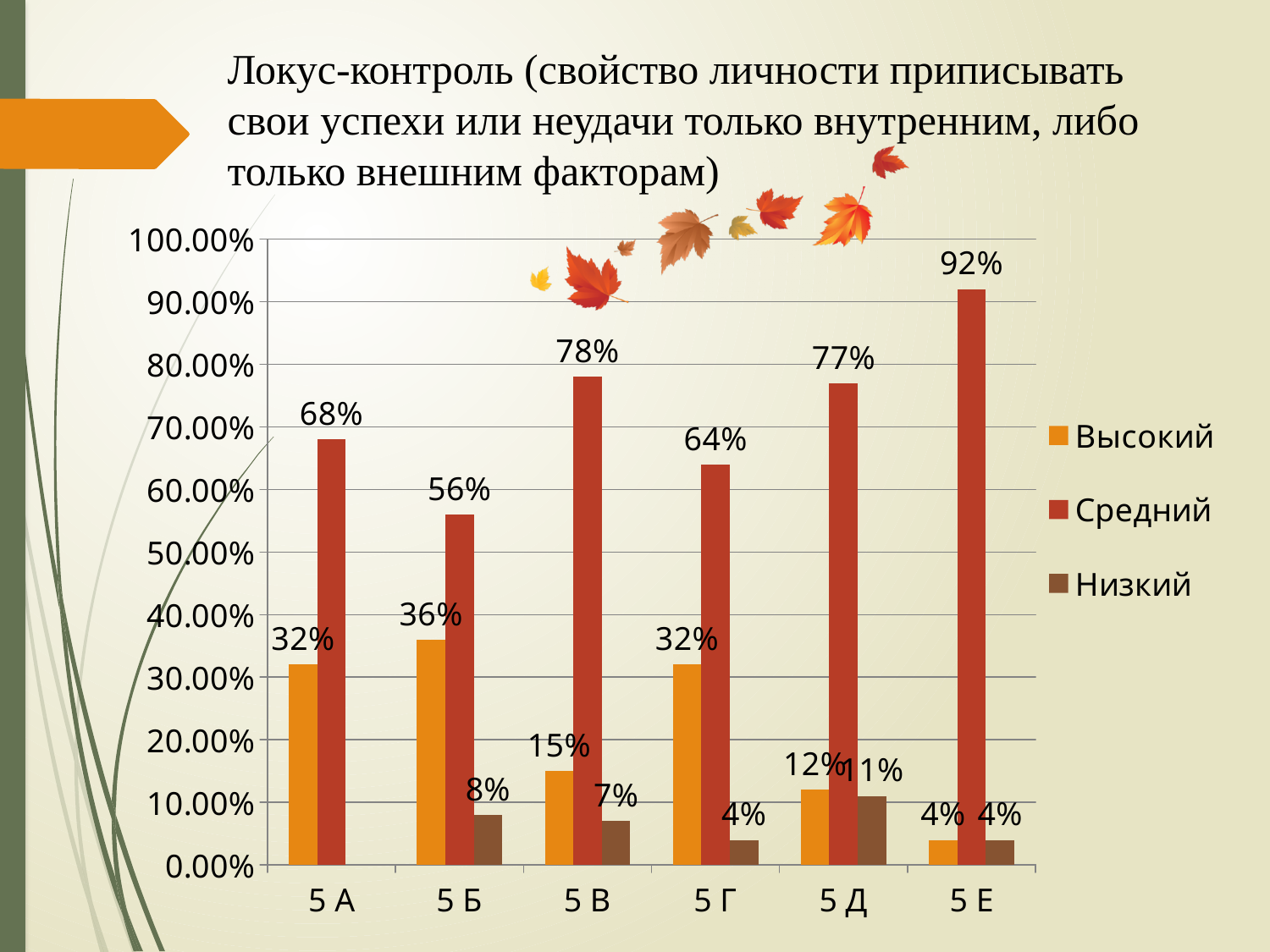
Which series is shown in orange in the legend? Высокий Which is larger, the Высокий value for 5 А or the Высокий value for 5 Д? 5 А What kind of chart is shown on the slide? bar chart How many series does the legend list? 3 What is the value of Низкий for 5 Д? 11% How many categories are shown on the x axis? 6 What is the value of Высокий for 5 Б? 36% What is the value of Высокий for 5 В? 15% Which category has the highest Средний value? 5 Е Which category has the lowest Высокий value? 5 Е What is the difference between the Средний values for 5 В and 5 Б? 22% What is the value of Средний for 5 Е? 92%